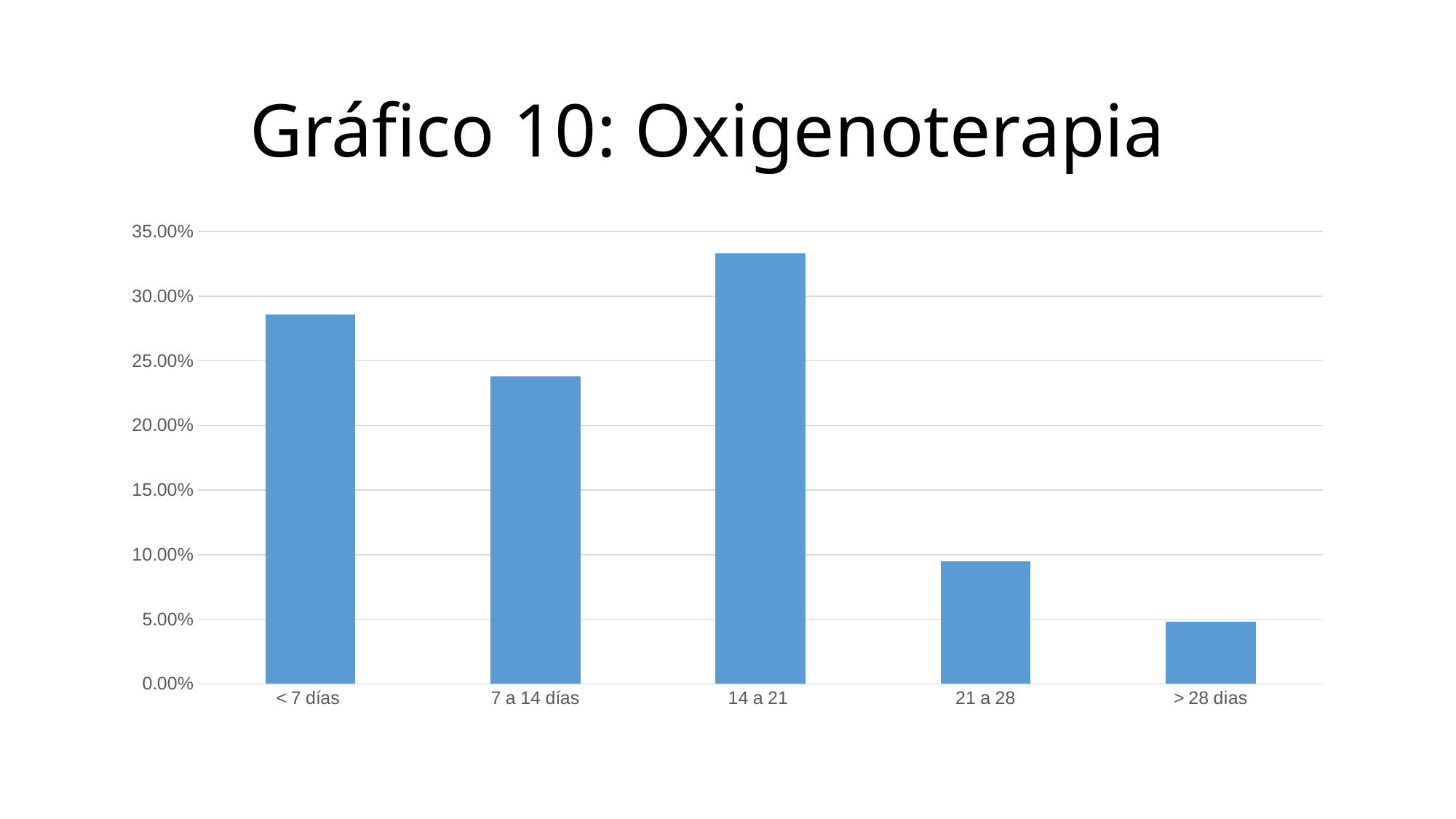
Is the value for 14 a 21 greater or less than 30.00%? greater Which category has the highest value? 14 a 21 Which category has the lowest value? > 28 dias What is the title of the chart? Gráfico 10: Oxigenoterapia Which is larger, the value for < 7 días or the value for 7 a 14 días? < 7 días Is the value for 7 a 14 días greater or less than 25.00%? less What kind of chart is shown on the slide? bar chart Which is larger, the value for 21 a 28 or the value for > 28 dias? 21 a 28 Is the value for < 7 días greater or less than 25.00%? greater How many categories are shown on the x axis? 5